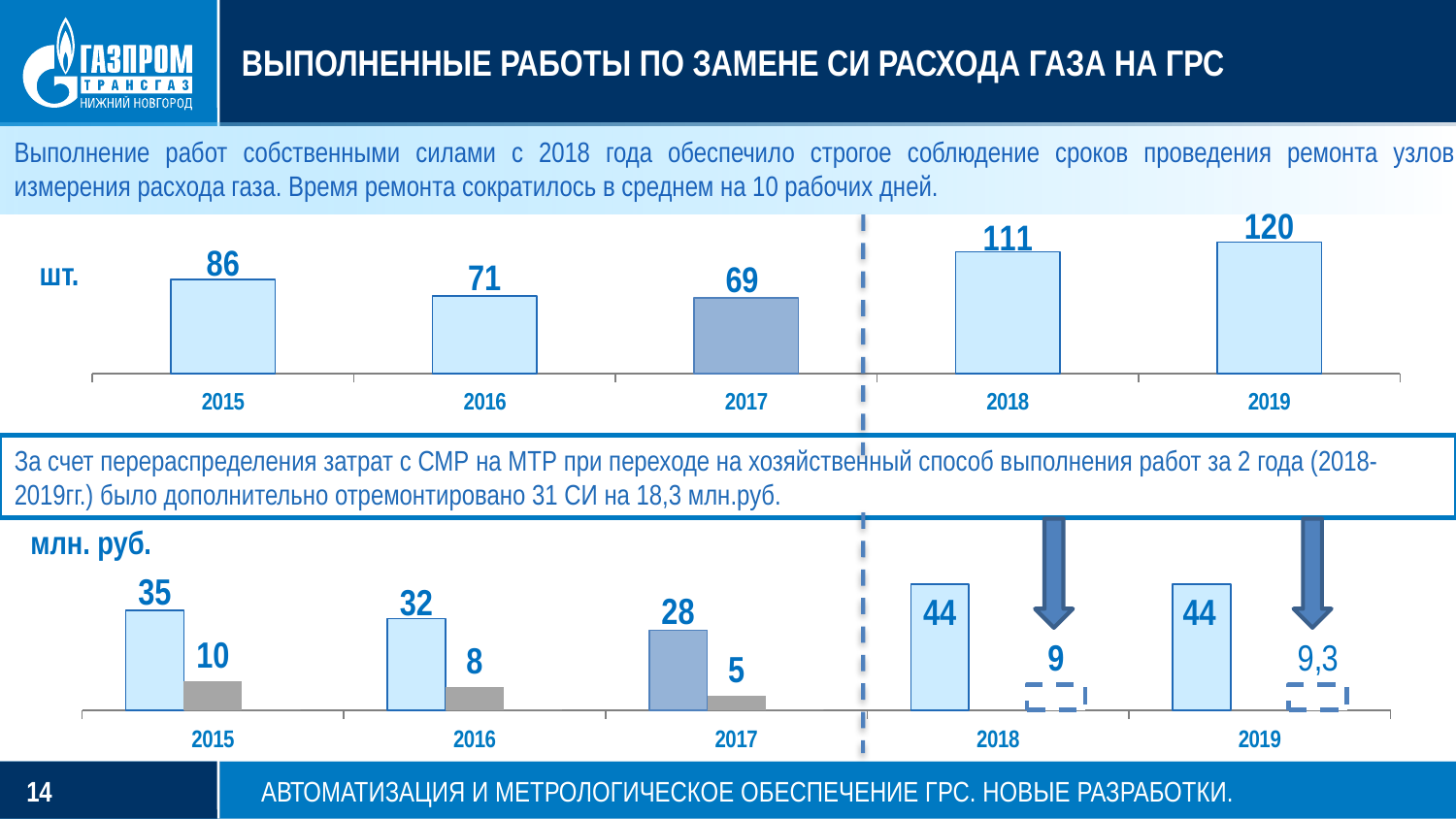
In the bottom chart (млн. руб.), what is the difference between the light blue bar and the gray bar for 2015? 25 In the top chart (шт.), what is the value for 2015? 86 In the bottom chart (млн. руб.), what is the value of the light blue bar for 2017? 28 In the top chart (шт.), which year has the highest value? 2019 What kind of chart is the top chart (шт.)? bar chart In the top chart (шт.), what is the difference between the values for 2019 and 2017? 51 In the bottom chart (млн. руб.), what is the value of the second (gray) bar for 2016? 8 In the top chart (шт.), what is the value for 2018? 111 In the bottom chart (млн. руб.), which is larger: the light blue bar for 2015 or the light blue bar for 2018? 2018 In the top chart (шт.), how many years are shown on the x axis? 5 In the bottom chart (млн. руб.), what is the value of the dashed bar for 2019? 9,3 In the top chart (шт.), which year has the lowest value? 2017